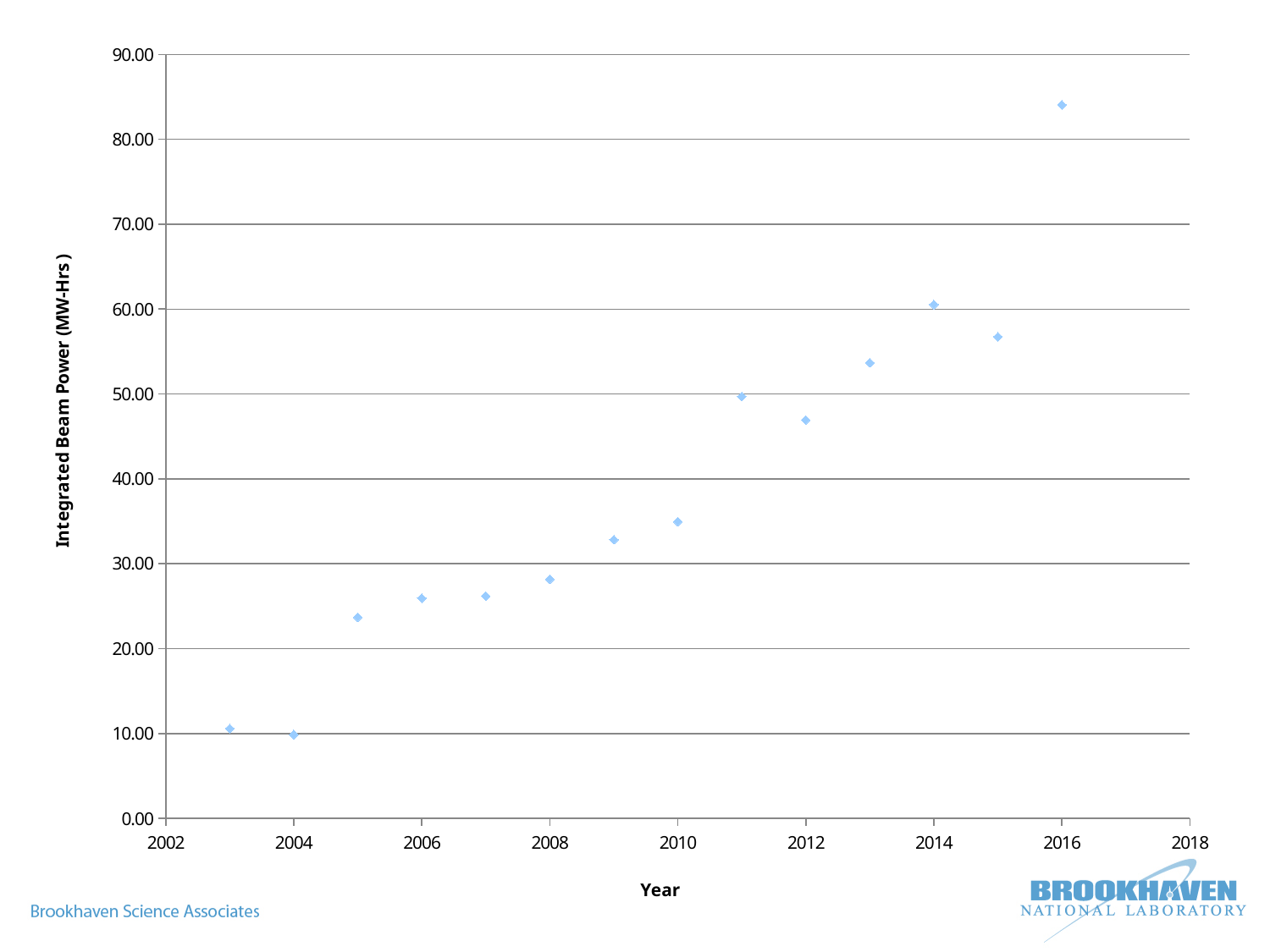
What kind of chart is shown on the slide? Scatter plot How many data points are plotted on the chart? 14 What is the label of the vertical axis? Integrated Beam Power (MW-Hrs) Overall, do the values rise or fall from 2003 to 2016? Rise Is the value for 2012 greater or less than 50? less Is the value for 2016 greater or less than 80? greater Is the value for 2013 greater or less than 50? greater Which year has the larger integrated beam power, 2014 or 2015? 2014 Which year has the highest integrated beam power? 2016 Which year has the larger integrated beam power, 2011 or 2012? 2011